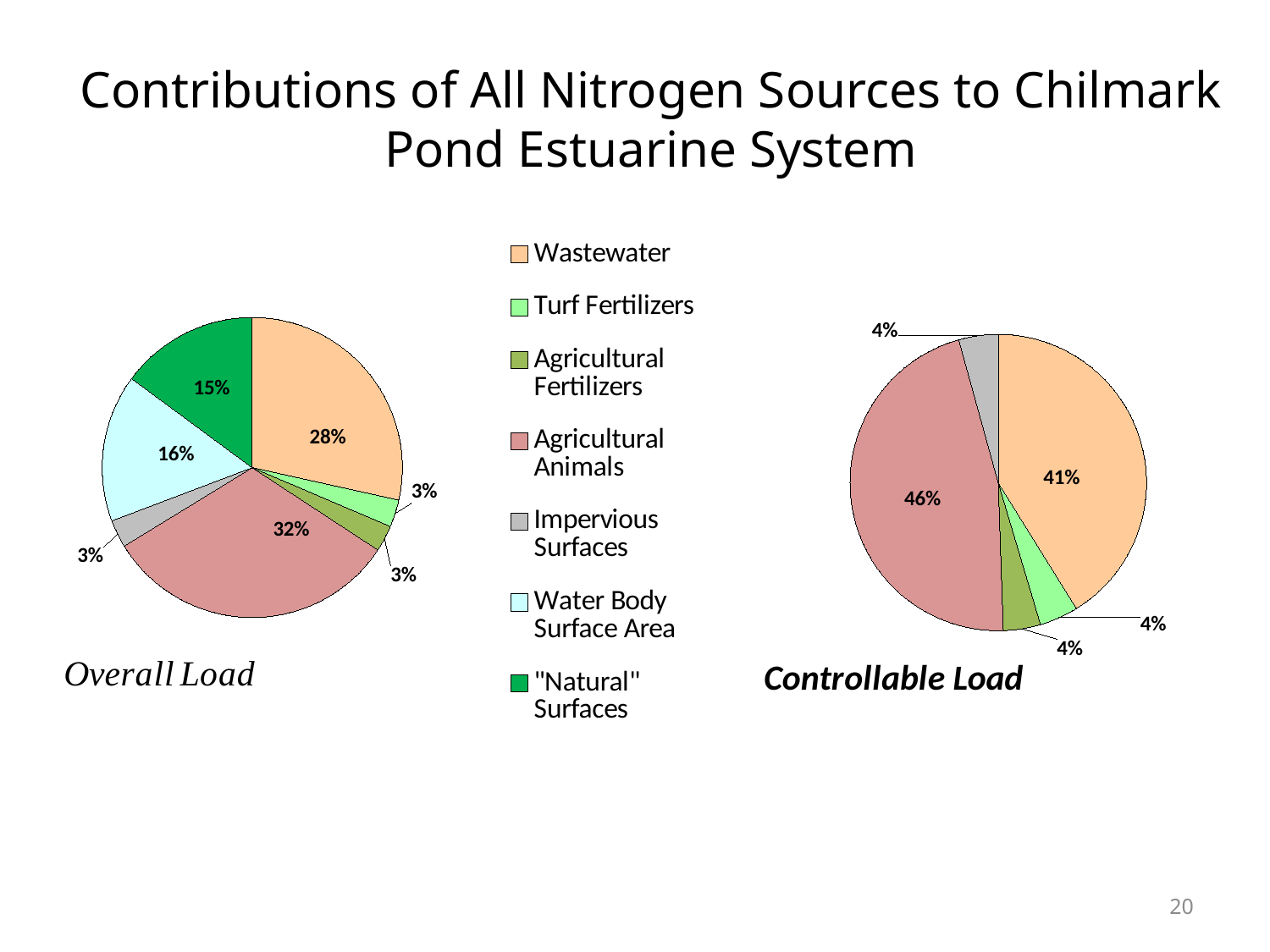
In the Controllable Load chart, what share does Wastewater have? 41% In the Overall Load chart, what share does Water Body Surface Area have? 16% In the Overall Load chart, what share does Agricultural Animals have? 32% How many entries does the legend list? 7 How many slices does the Controllable Load chart have? 5 In the Controllable Load chart, which is larger, Wastewater or Agricultural Animals? Agricultural Animals In the Overall Load chart, what is the difference between the Agricultural Animals share and the Wastewater share? 4% In the Overall Load chart, which source has the largest share? Agricultural Animals What kind of chart is the Overall Load chart? pie chart In the Controllable Load chart, what is the difference between the Agricultural Animals share and the Wastewater share? 5%